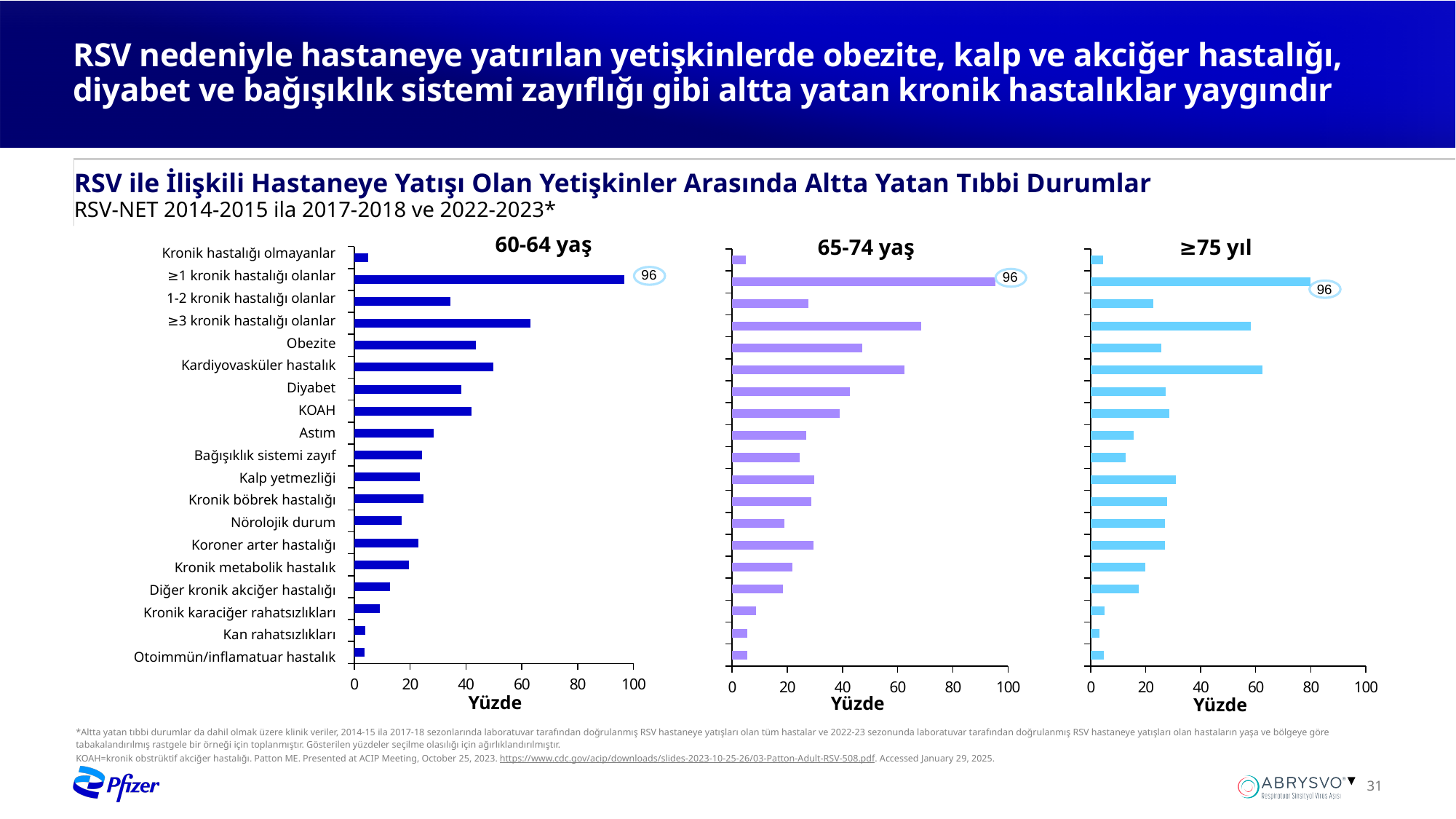
In the ≥75 yıl chart, what is the value for ≥1 kronik hastalığı olanlar? 96 What is the x-axis label on the charts? Yüzde In the 65-74 yaş chart, is the value for ≥3 kronik hastalığı olanlar greater or less than 40? greater In the 60-64 yaş chart, which category has the highest value? ≥1 kronik hastalığı olanlar In the 60-64 yaş chart, is the value for Kronik hastalığı olmayanlar greater or less than 20? less How many categories are listed on the y axis of the 60-64 yaş chart? 19 How many charts are shown on the slide? 3 In the 60-64 yaş chart, what is the value for ≥1 kronik hastalığı olanlar? 96 In the 60-64 yaş chart, is the value for Kardiyovasküler hastalık greater or less than 40? greater In the 65-74 yaş chart, what is the value for ≥1 kronik hastalığı olanlar? 96 In the ≥75 yıl chart, which is larger: Kardiyovasküler hastalık or Obezite? Kardiyovasküler hastalık What kind of chart is the 65-74 yaş chart? Bar chart